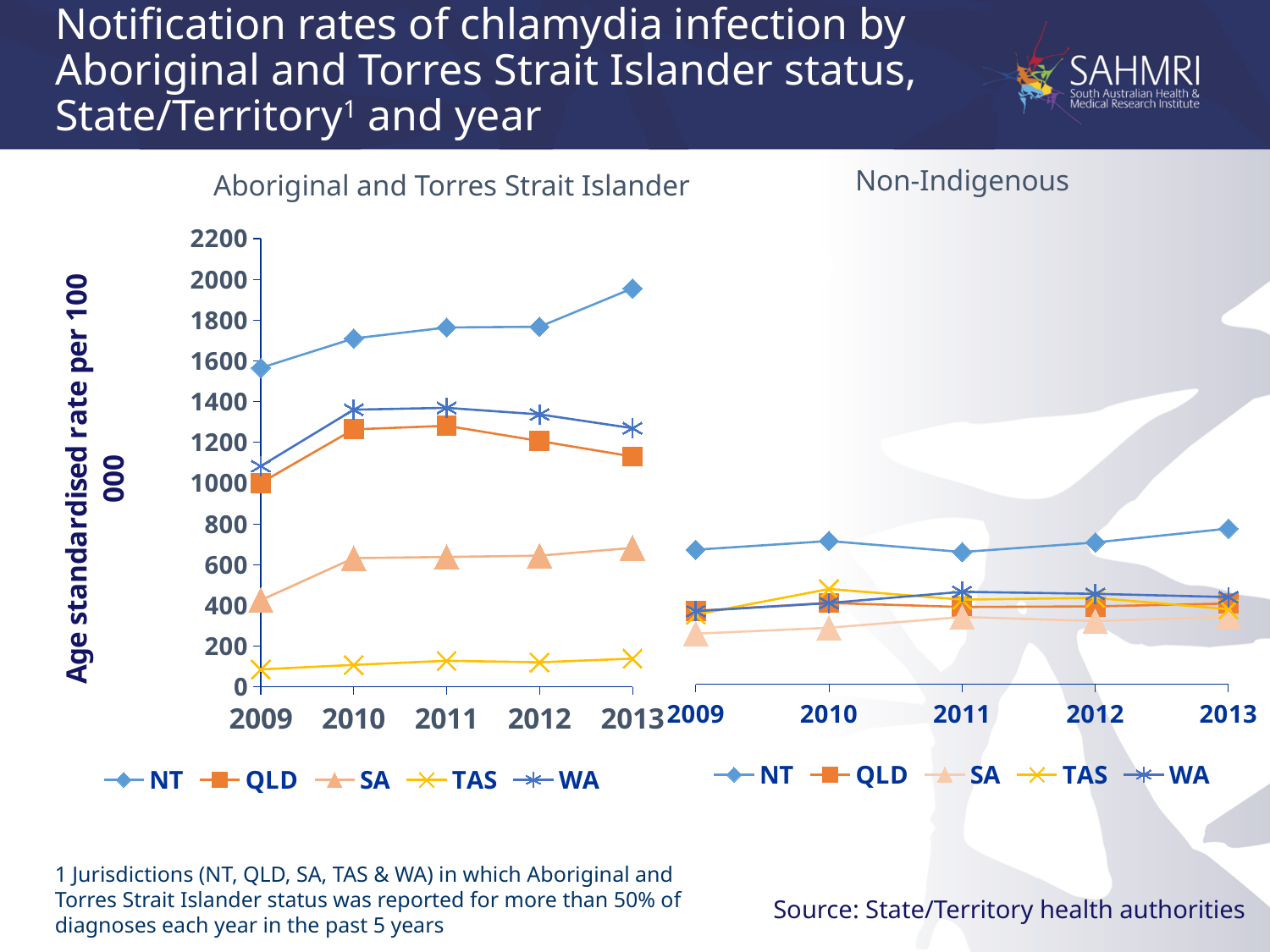
How many series does the legend of the Non-Indigenous chart list? 5 In the Non-Indigenous chart, is the value for NT in 2013 greater or less than 600? greater In the Non-Indigenous chart, which jurisdiction has the lowest rate in 2009? SA In the Aboriginal and Torres Strait Islander chart, does the NT line rise or fall from 2009 to 2013? rise In the Non-Indigenous chart, which jurisdiction has the highest rate in 2013? NT How many years are shown on the x axis of the Aboriginal and Torres Strait Islander chart? 5 In the Aboriginal and Torres Strait Islander chart, is the value for TAS in 2012 greater or less than 200? less In the Aboriginal and Torres Strait Islander chart, which jurisdiction has the lowest rate in 2011? TAS In the Non-Indigenous chart, which is larger in 2010, the value for NT or the value for SA? NT What kind of chart is the Aboriginal and Torres Strait Islander chart? line chart In the Aboriginal and Torres Strait Islander chart, which jurisdiction has the highest rate in 2013? NT In the Aboriginal and Torres Strait Islander chart, is the value for NT in 2013 greater or less than 1800? greater